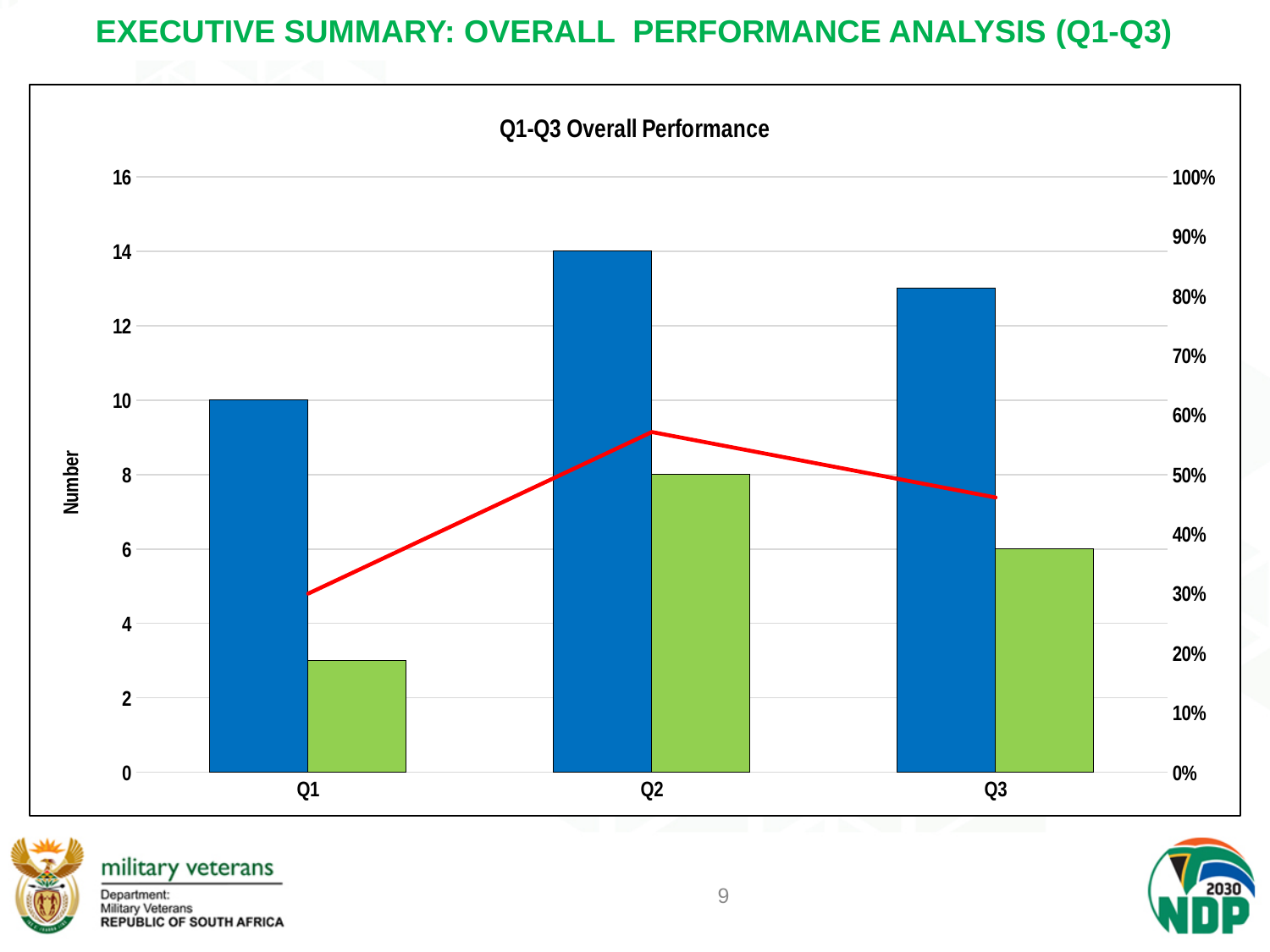
What is the value of the blue bar for Q2? 14 Is the value of the blue bar for Q3 greater or less than 12? greater What is the difference between the blue bar and the green bar for Q2? 6 What is the value of the blue bar for Q1? 10 Which quarter has the lowest green bar? Q1 How many quarters are shown on the x axis of the chart? 3 What is the value of the green bar for Q2? 8 Which quarter has the highest blue bar? Q2 Is the value of the red line at Q2 greater or less than 50%? greater What kind of chart is shown on the slide? Bar chart with a line What is the title of the chart? Q1-Q3 Overall Performance What is the value of the green bar for Q3? 6